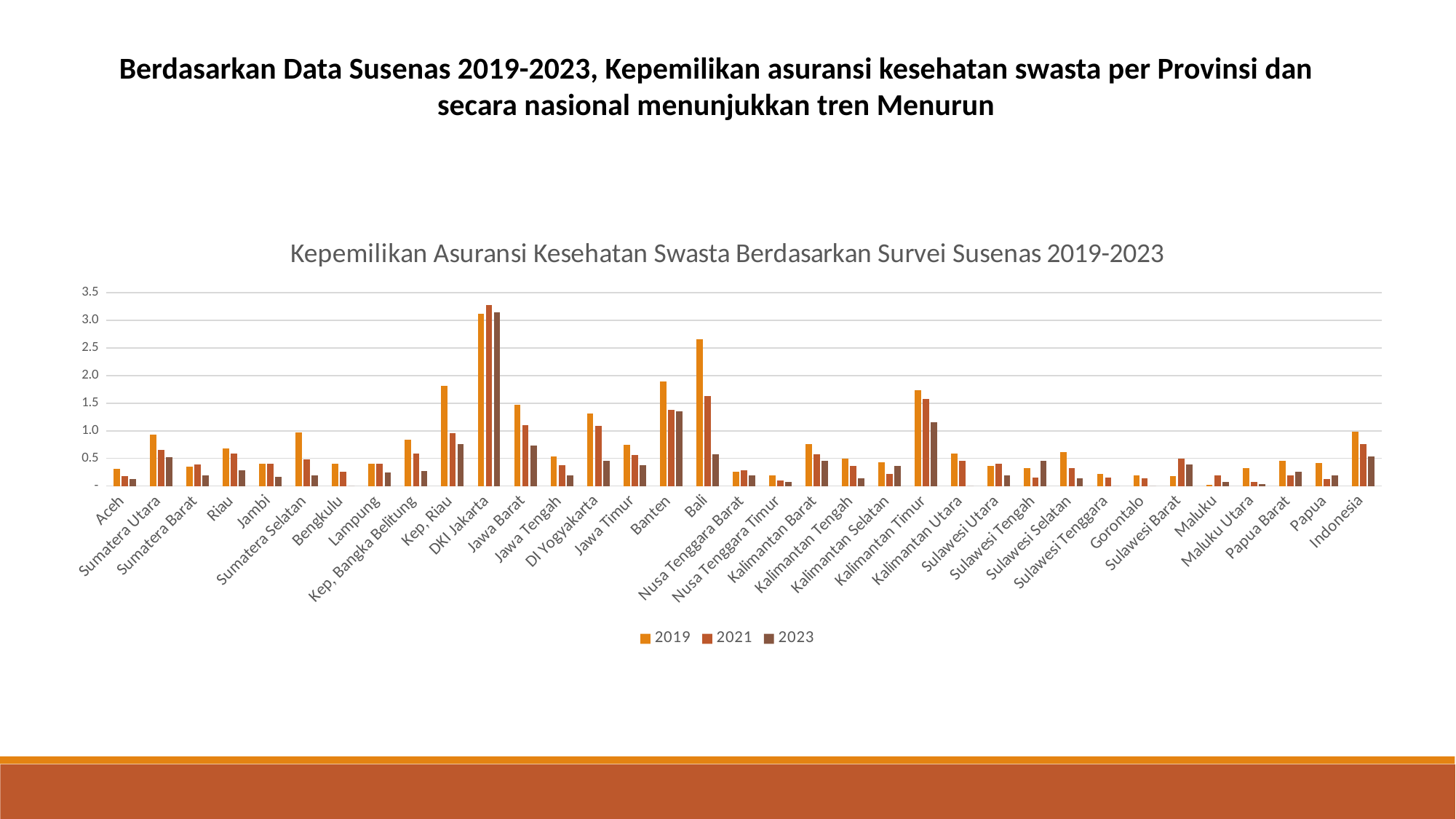
Which category has the highest value for the 2019 series? DKI Jakarta How many categories are shown along the x axis? 35 Do the values for Indonesia rise or fall from 2019 to 2023? fall How many series does the legend list? 3 Is the 2021 value for DKI Jakarta greater or less than 3.0? greater Is the 2023 value for Bali greater or less than 1.0? less What kind of chart is shown on the slide? bar chart Is the 2019 value for Bali greater or less than 2.5? greater Which is larger for the 2019 series: Bali or Banten? Bali Which category has the highest value for the 2021 series? DKI Jakarta Which is larger for Bali: the 2019 value or the 2023 value? 2019